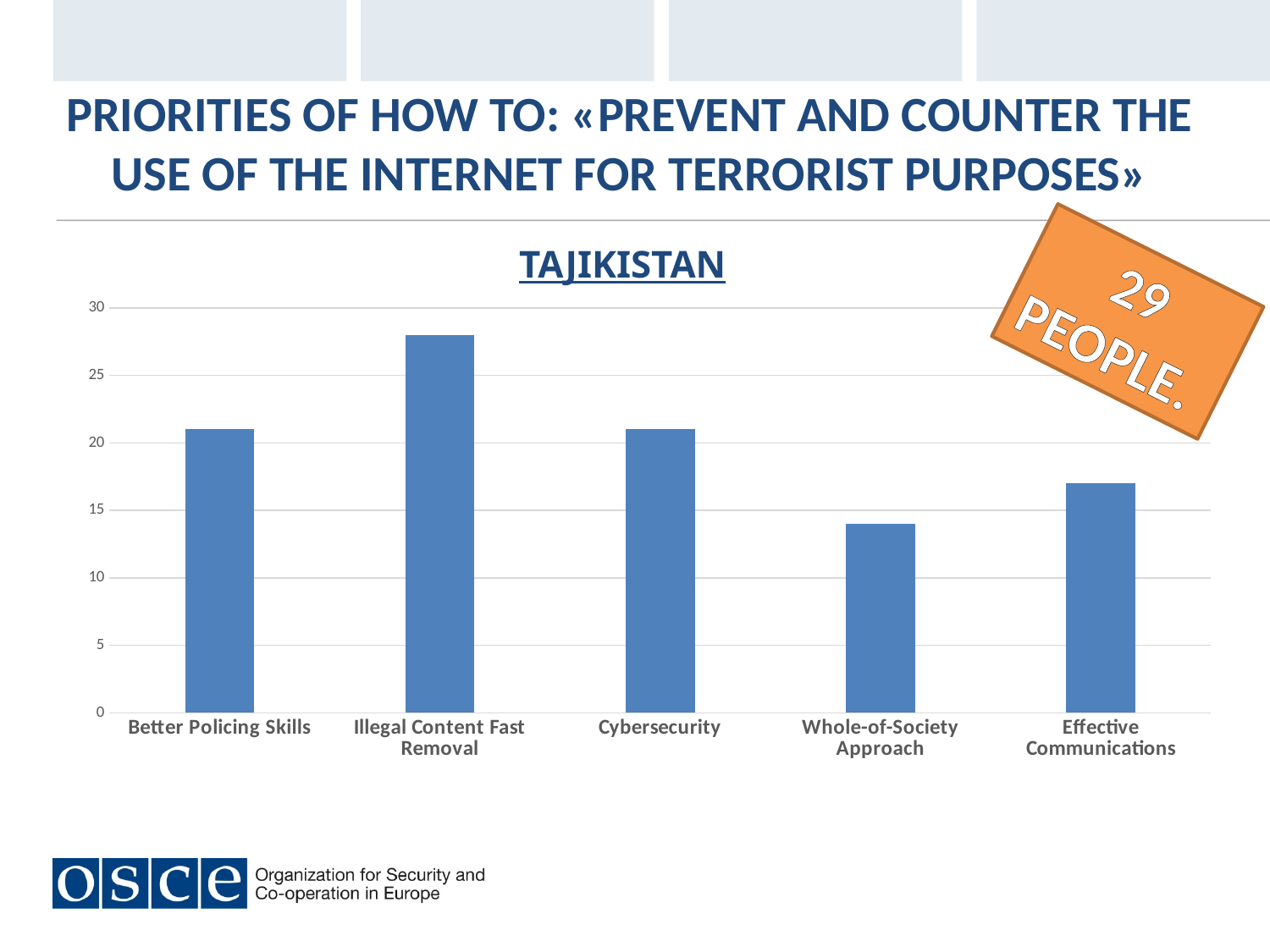
Is the value for Cybersecurity greater or less than 25? less Which category has the lowest bar in the chart? Whole-of-Society Approach What is the title shown above the chart? TAJIKISTAN What kind of chart is shown on the slide? bar chart Is the value for Whole-of-Society Approach greater or less than 15? less Is the value for Effective Communications greater or less than 15? greater Which is larger, the value for Whole-of-Society Approach or the value for Cybersecurity? Cybersecurity Which is larger, the value for Illegal Content Fast Removal or the value for Effective Communications? Illegal Content Fast Removal How many categories are shown on the x axis of the chart? 5 Which category has the highest bar in the chart? Illegal Content Fast Removal